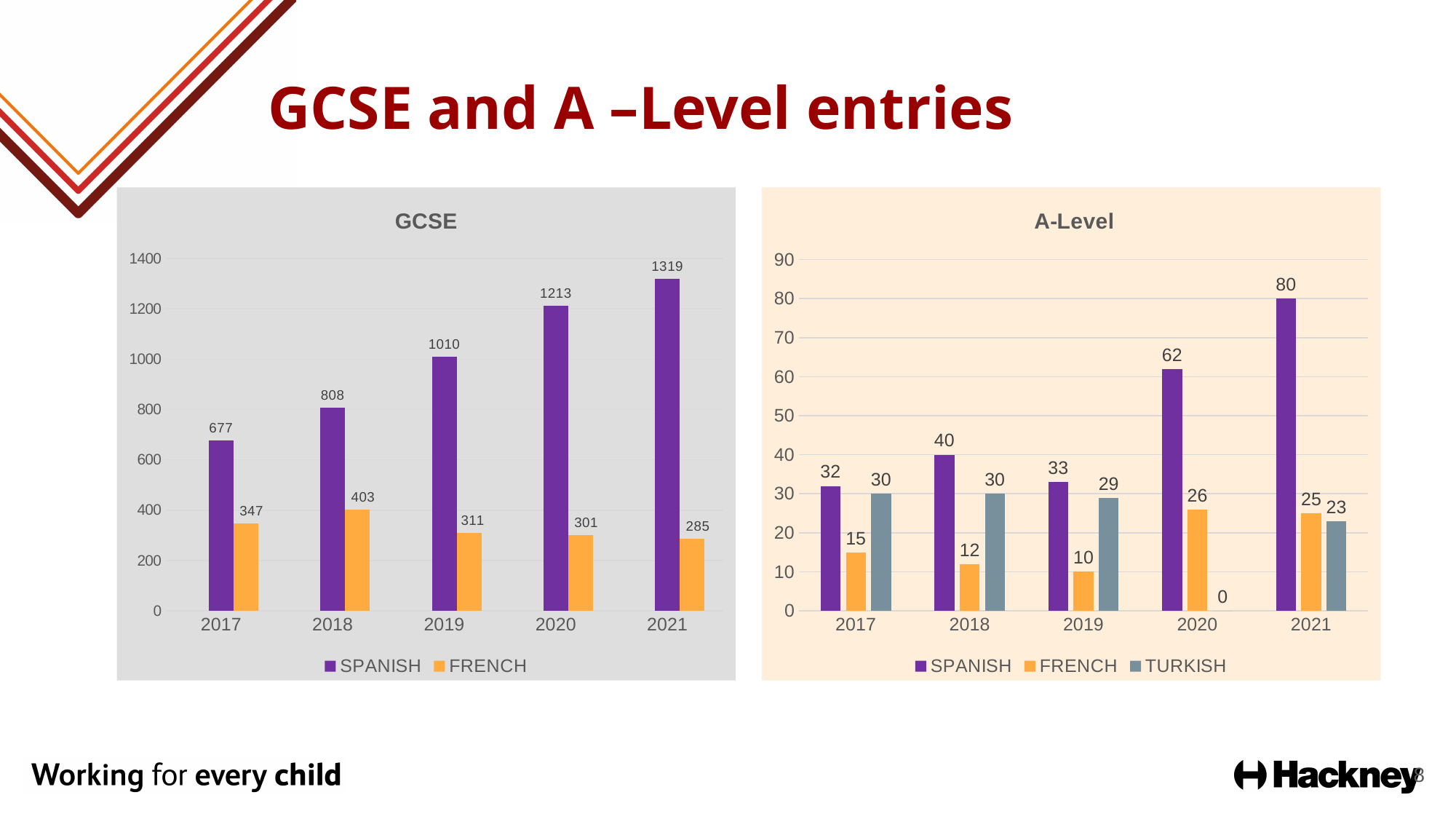
In the GCSE chart, what is the value for French in 2018? 403 In the A-Level chart, what is the value for French in 2020? 26 In the A-Level chart, what is the value for Turkish in 2019? 29 In the A-Level chart, which year has the highest value for Spanish? 2021 In the GCSE chart, do the Spanish values rise or fall from 2017 to 2021? rise In the GCSE chart, what is the value for Spanish in 2021? 1319 In the A-Level chart, which is larger in 2017: the value for Spanish or the value for Turkish? Spanish In the A-Level chart, what is the difference between the Spanish values in 2021 and 2020? 18 How many series does the legend of the A-Level chart list? 3 In the GCSE chart, what is the difference between the Spanish and French values in 2020? 912 What kind of chart is the GCSE chart? bar chart In the GCSE chart, which year has the lowest value for French? 2021